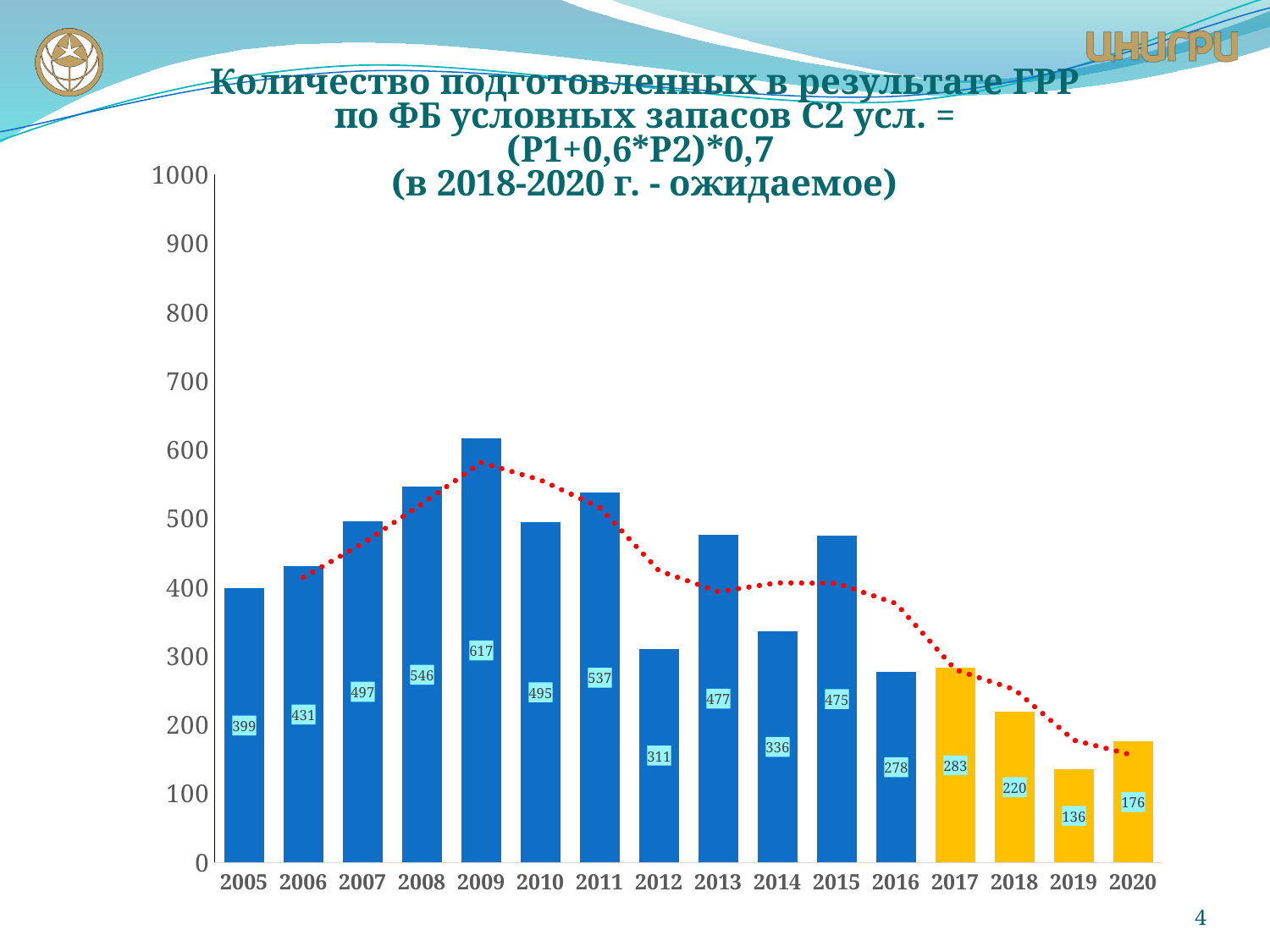
What is the difference between the values for 2017 and 2018? 63 Is the value for 2008 greater or less than 500? greater What is the value for 2016? 278 How many years are shown on the x axis? 16 Which year has the highest value? 2009 What is the value for 2009? 617 Do the values generally rise or fall from 2015 to 2019? fall Which is larger, the value for 2012 or the value for 2014? 2014 Which year has the lowest value? 2019 What is the value for 2020? 176 What kind of chart is this? bar chart What is the difference between the values for 2009 and 2019? 481